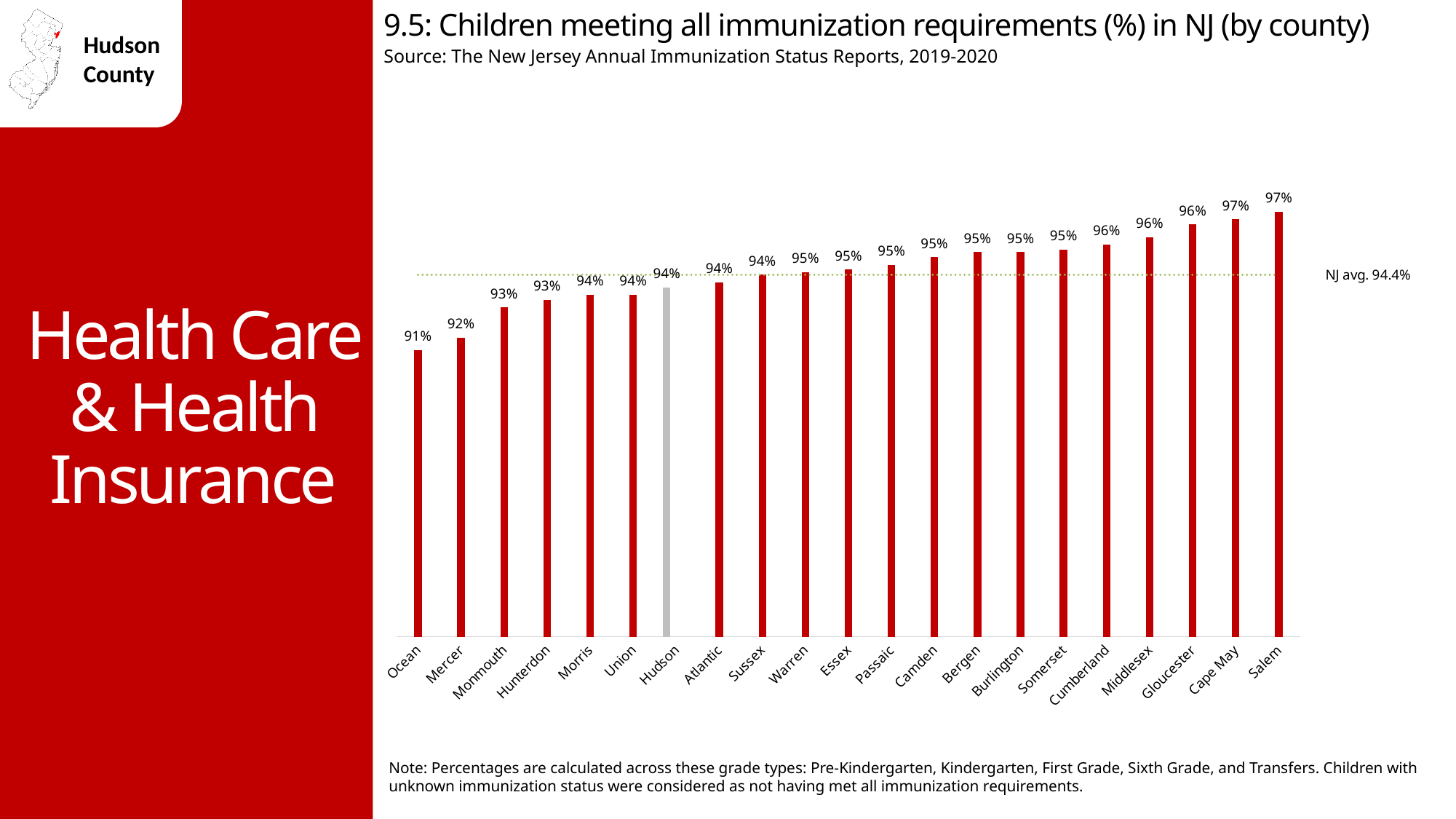
What is the difference in percentage points between Salem and Ocean counties? 6 percentage points Which has a higher value, Hudson or Salem? Salem What is the value shown for Mercer County? 92% Which county has the lowest percentage of children meeting all immunization requirements? Ocean What is the difference in percentage points between Hudson and Ocean counties? 3 percentage points What is the value shown for Cumberland County? 96% What is the value shown for Ocean County? 91% Which has a higher value, Mercer or Monmouth? Monmouth What type of chart is shown on the slide? Bar chart What percentage of children in Hudson County met all immunization requirements? 94% Do the values generally rise or fall from left to right across the counties? Rise How many counties are shown on the chart? 21